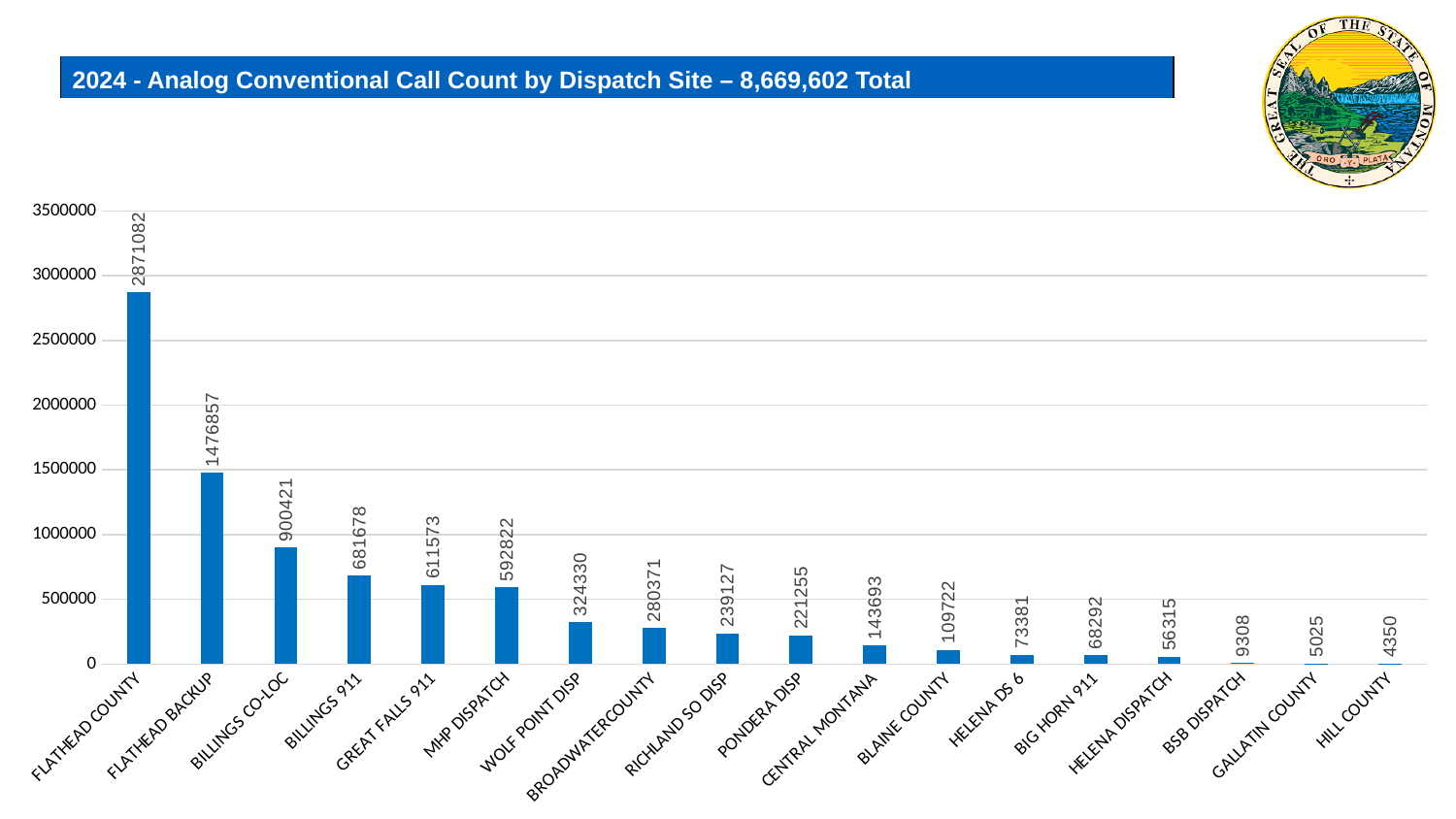
What is the call count for MHP DISPATCH? 592822 What is the difference in call count between BILLINGS 911 and GREAT FALLS 911? 70105 What is the call count for BLAINE COUNTY? 109722 Which has a higher call count, WOLF POINT DISP or BROADWATERCOUNTY? WOLF POINT DISP What is the call count for FLATHEAD COUNTY? 2871082 How many dispatch sites are shown on the chart? 18 Is the call count for BILLINGS CO-LOC greater or less than 1000000? less What total call count is stated in the chart title? 8,669,602 Which dispatch site has the highest call count? FLATHEAD COUNTY Which dispatch site has the lowest call count? HILL COUNTY What is the difference in call count between FLATHEAD COUNTY and FLATHEAD BACKUP? 1394225 What kind of chart is shown on the slide? bar chart